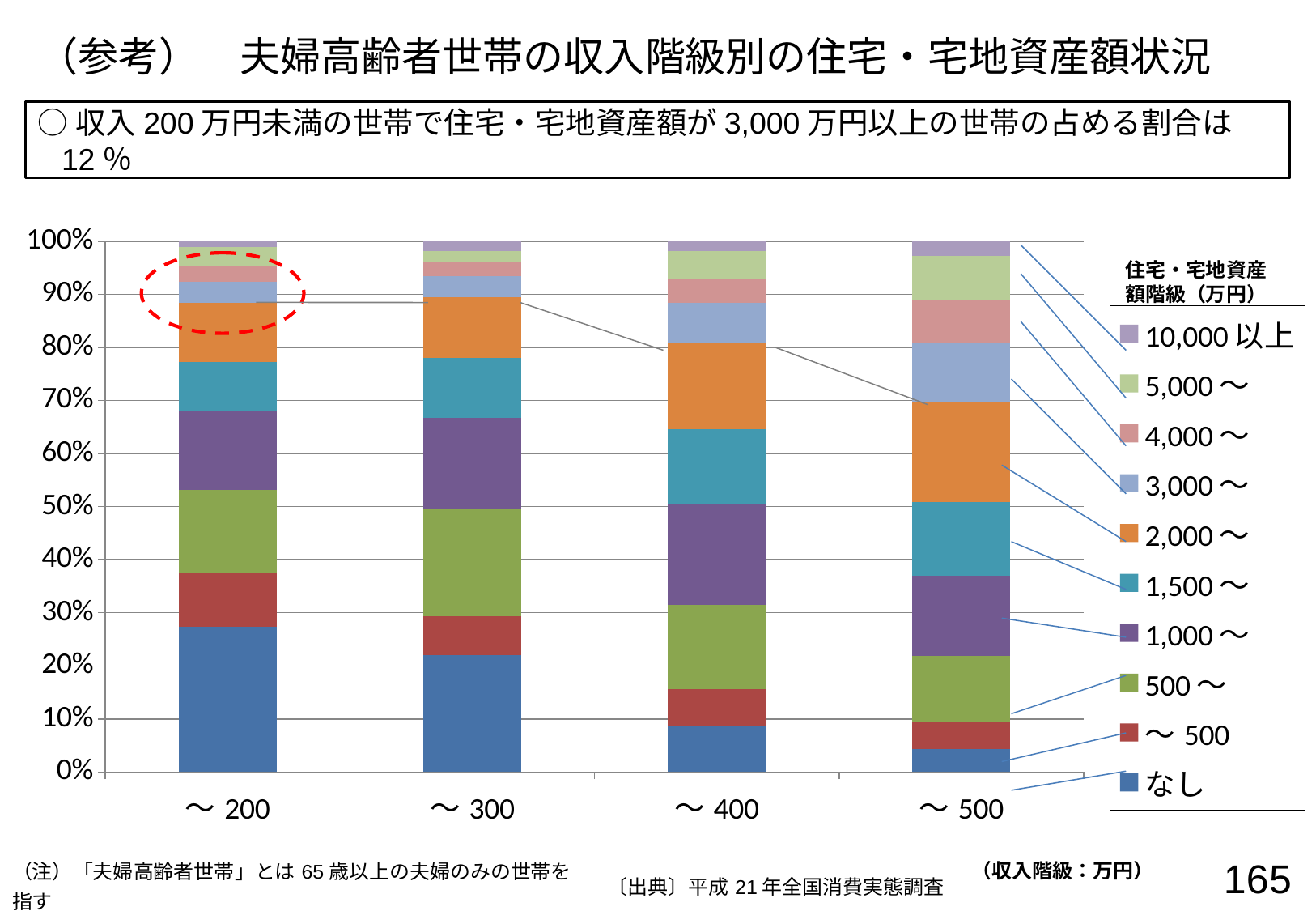
What kind of chart is shown on the slide? stacked bar chart What is the title of the legend? 住宅・宅地資産額階級（万円） Which income category has the largest share for なし? ～200 Does the share for なし rise or fall as income moves from ～200 to ～500? fall Which has a larger share for 3,000～, ～200 or ～500? ～500 Is the share for なし in the ～500 category greater or less than 10%? less Which has a larger share for なし, ～200 or ～300? ～200 How many series does the legend list? 10 Which legend entry is shown at the top of the legend? 10,000 以上 Which income category has the smallest share for なし? ～500 Is the share for なし in the ～200 category greater or less than 20%? greater How many income categories are shown on the x axis? 4